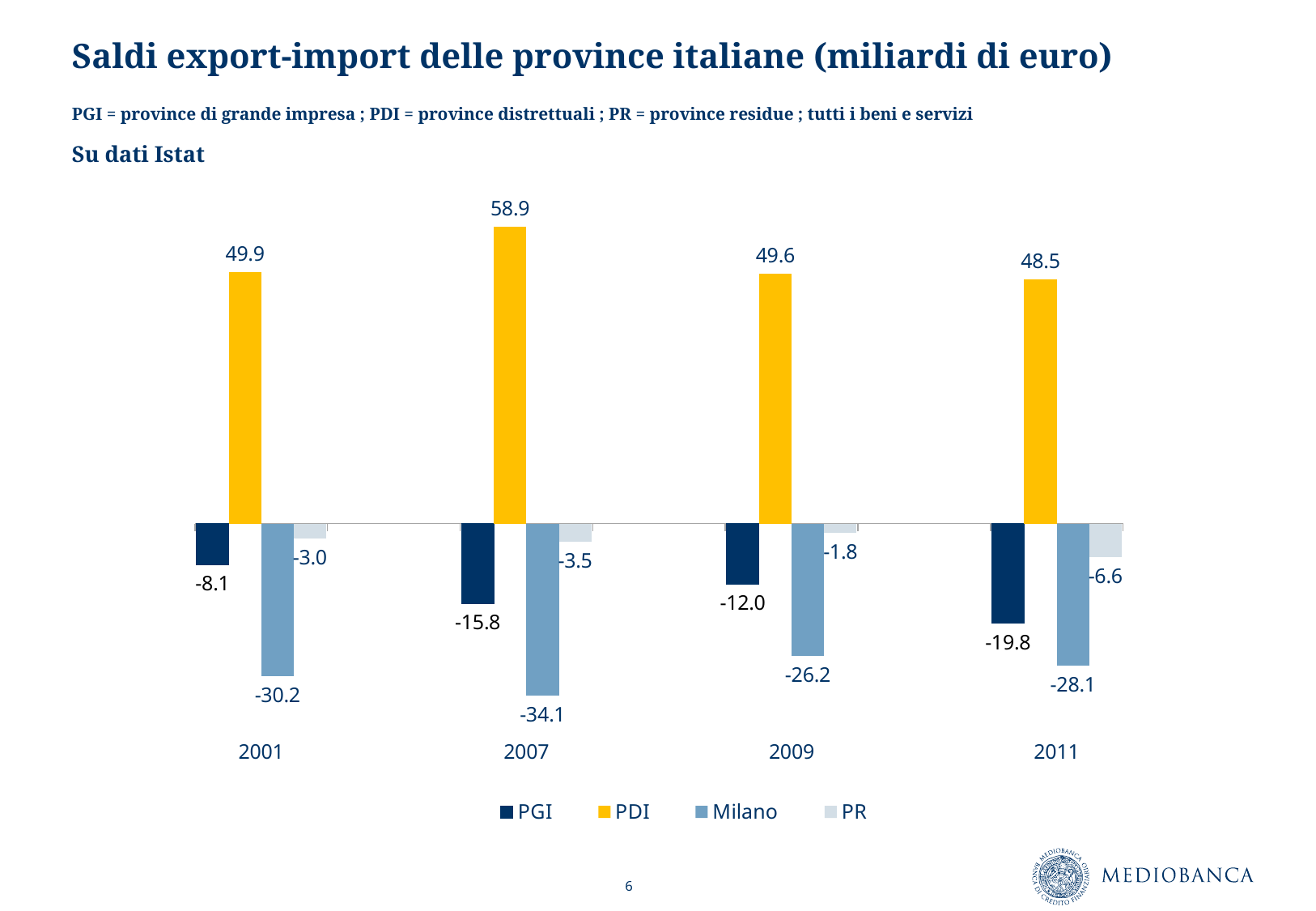
Do the PGI values rise or fall from 2009 to 2011? Fall Which is larger, the PGI value in 2001 or the PGI value in 2011? 2001 How many series does the legend list? 4 What is the value for Milano in 2011? -28.1 In which year is the PDI value highest? 2007 What is the value for PGI in 2009? -12.0 How many years are shown on the x axis? 4 What is the value for PR in 2001? -3.0 What is the value for PDI in 2007? 58.9 What is the difference between the PDI values in 2007 and 2011? 10.4 In which year is the Milano value lowest? 2007 What kind of chart is shown on the slide? Bar chart